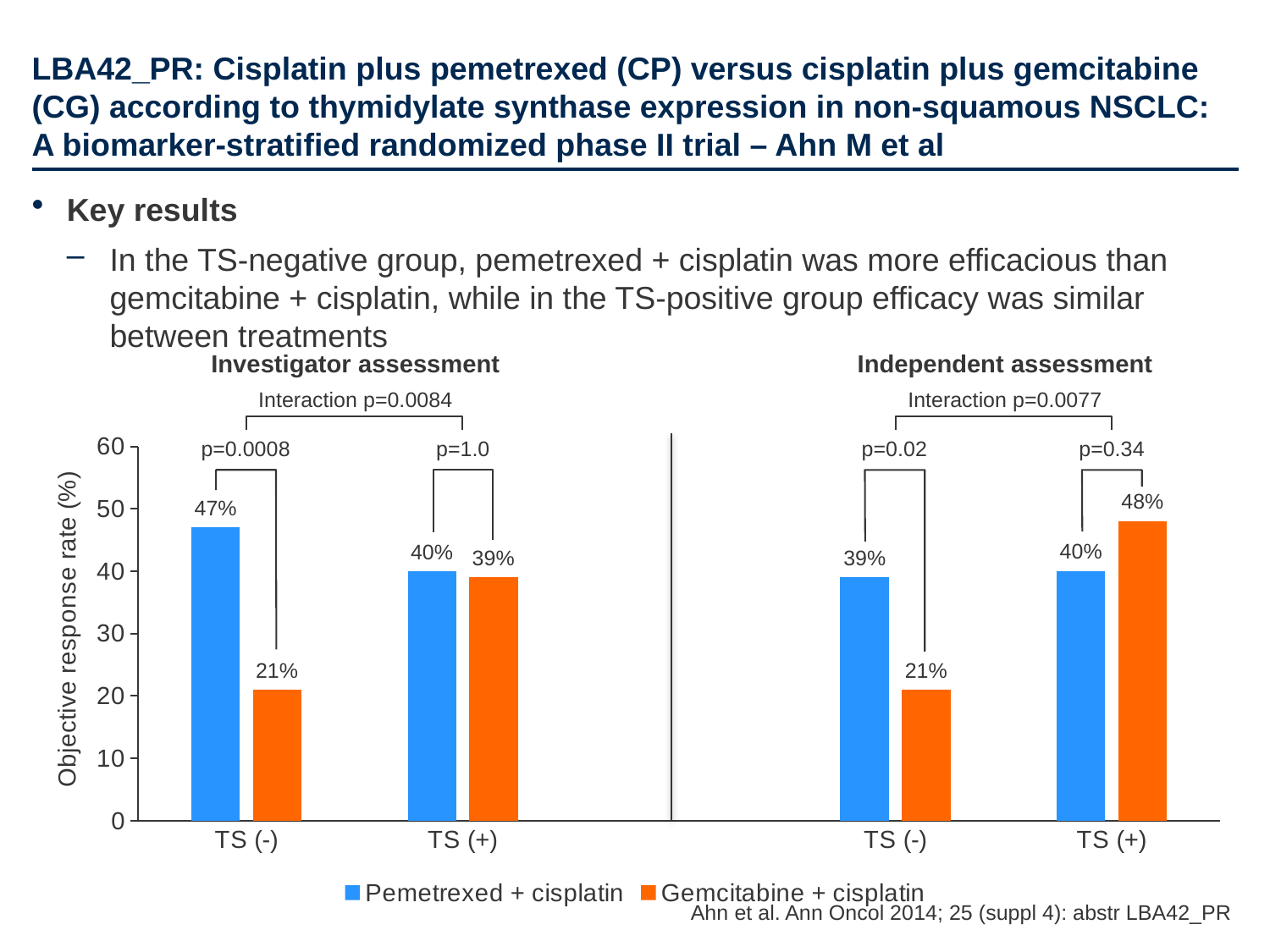
What is the interaction p-value shown above the Investigator assessment chart? p=0.0084 What type of chart is used to show the objective response rates? Bar chart How many series does the legend list for the charts? 2 In the Investigator assessment chart, what is the objective response rate for Gemcitabine + cisplatin in the TS (-) group? 21% In the Independent assessment chart, which bar has the highest objective response rate? Gemcitabine + cisplatin, TS (+) In the Independent assessment chart, which treatment has the higher objective response rate in the TS (+) group? Gemcitabine + cisplatin In the Independent assessment chart, what is the objective response rate for Gemcitabine + cisplatin in the TS (+) group? 48% In the Investigator assessment chart, what is the difference in objective response rate between Pemetrexed + cisplatin and Gemcitabine + cisplatin in the TS (-) group? 26% In the Investigator assessment chart, what is the objective response rate for Pemetrexed + cisplatin in the TS (-) group? 47% In the Independent assessment chart, what is the objective response rate for Pemetrexed + cisplatin in the TS (-) group? 39% In the Investigator assessment chart, which bar has the lowest objective response rate? Gemcitabine + cisplatin, TS (-) In the Independent assessment chart, what is the difference in objective response rate between Gemcitabine + cisplatin and Pemetrexed + cisplatin in the TS (+) group? 8%